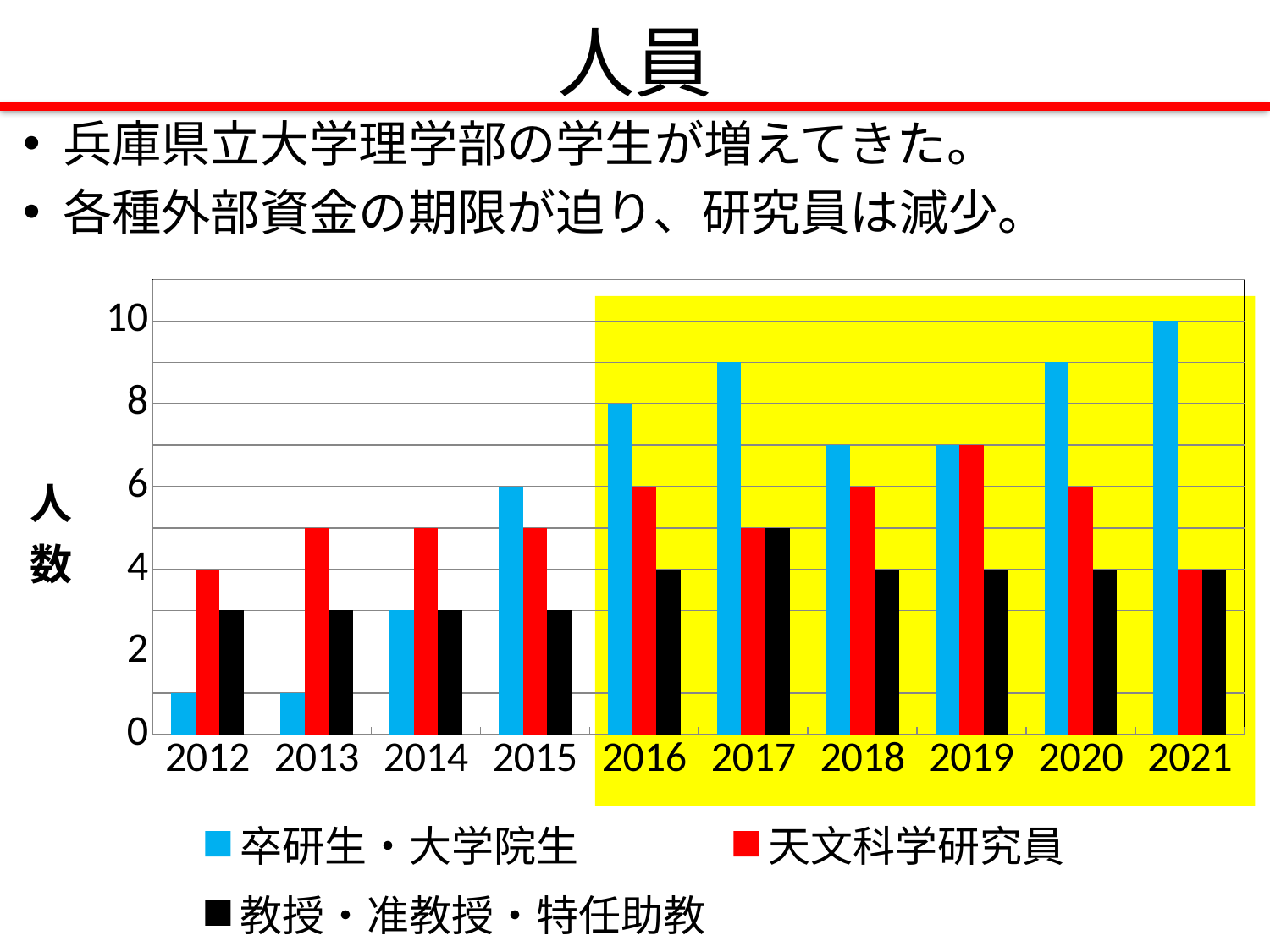
How many years are shown on the x axis? 10 How many series does the legend list? 3 What is the value for 天文科学研究員 in 2012? 4 What kind of chart is shown on the slide? bar chart What is the value for 卒研生・大学院生 in 2015? 6 What is the value for 卒研生・大学院生 in 2016? 8 What is the difference between 卒研生・大学院生 and 天文科学研究員 in 2021? 6 Is the value for 卒研生・大学院生 in 2014 greater or less than 4? less Is the value for 卒研生・大学院生 in 2017 greater or less than 8? greater In 2012, which is larger: 天文科学研究員 or 卒研生・大学院生? 天文科学研究員 In which year is the value for 卒研生・大学院生 highest? 2021 What is the value for 卒研生・大学院生 in 2021? 10